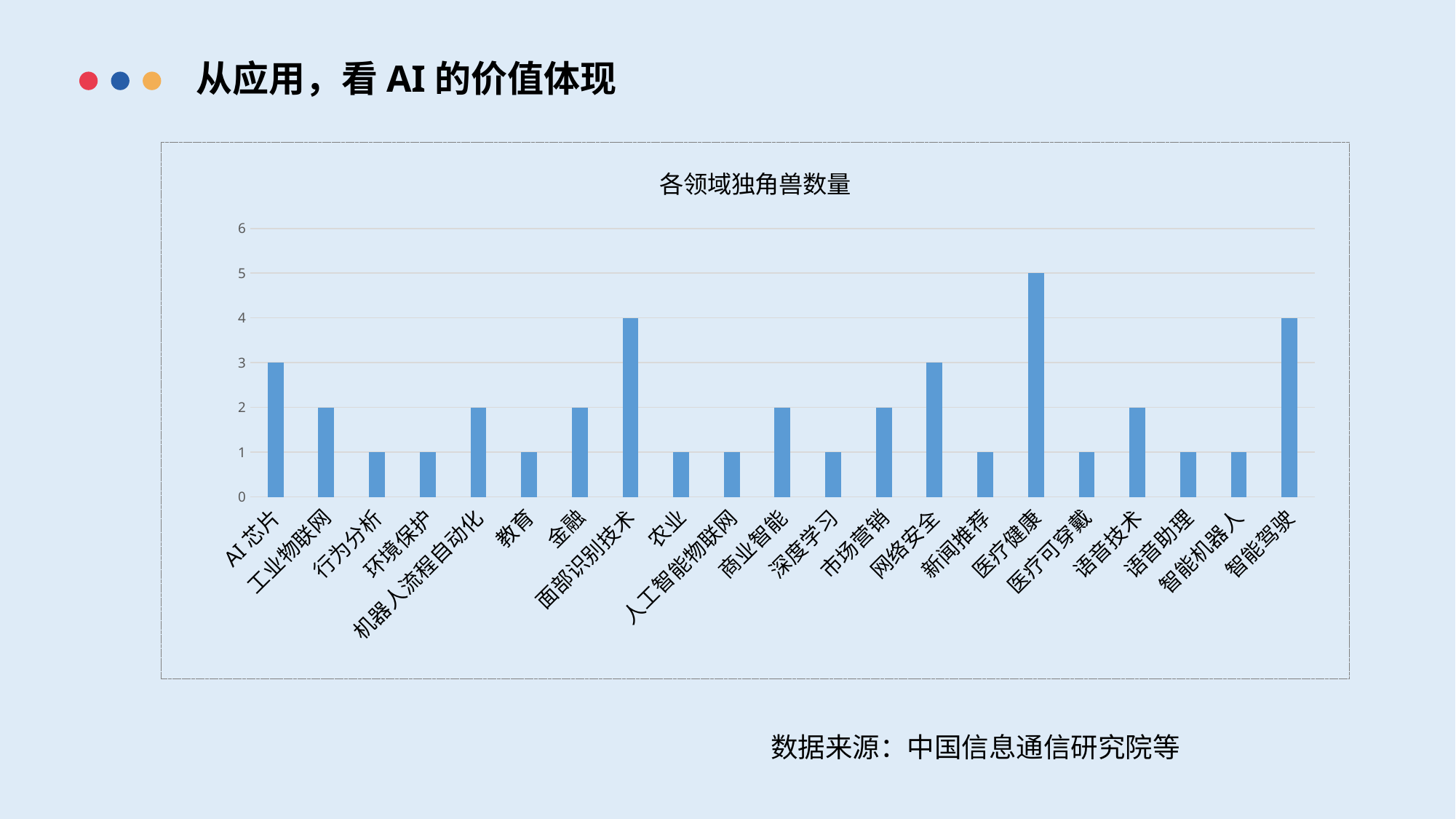
What is the value for AI 芯片? 3 What is the title of the chart? 各领域独角兽数量 Which category has the highest number of unicorns? 医疗健康 What is the value for 智能驾驶? 4 How many categories are shown on the x axis? 21 What is the value for 网络安全? 3 What is the value for 面部识别技术? 4 What is the value for 医疗健康? 5 What type of chart is shown on the slide? bar chart What is the difference between the values for 智能驾驶 and 语音技术? 2 Which is larger, the value for 工业物联网 or the value for 农业? 工业物联网 What is the difference between the values for 医疗健康 and 面部识别技术? 1